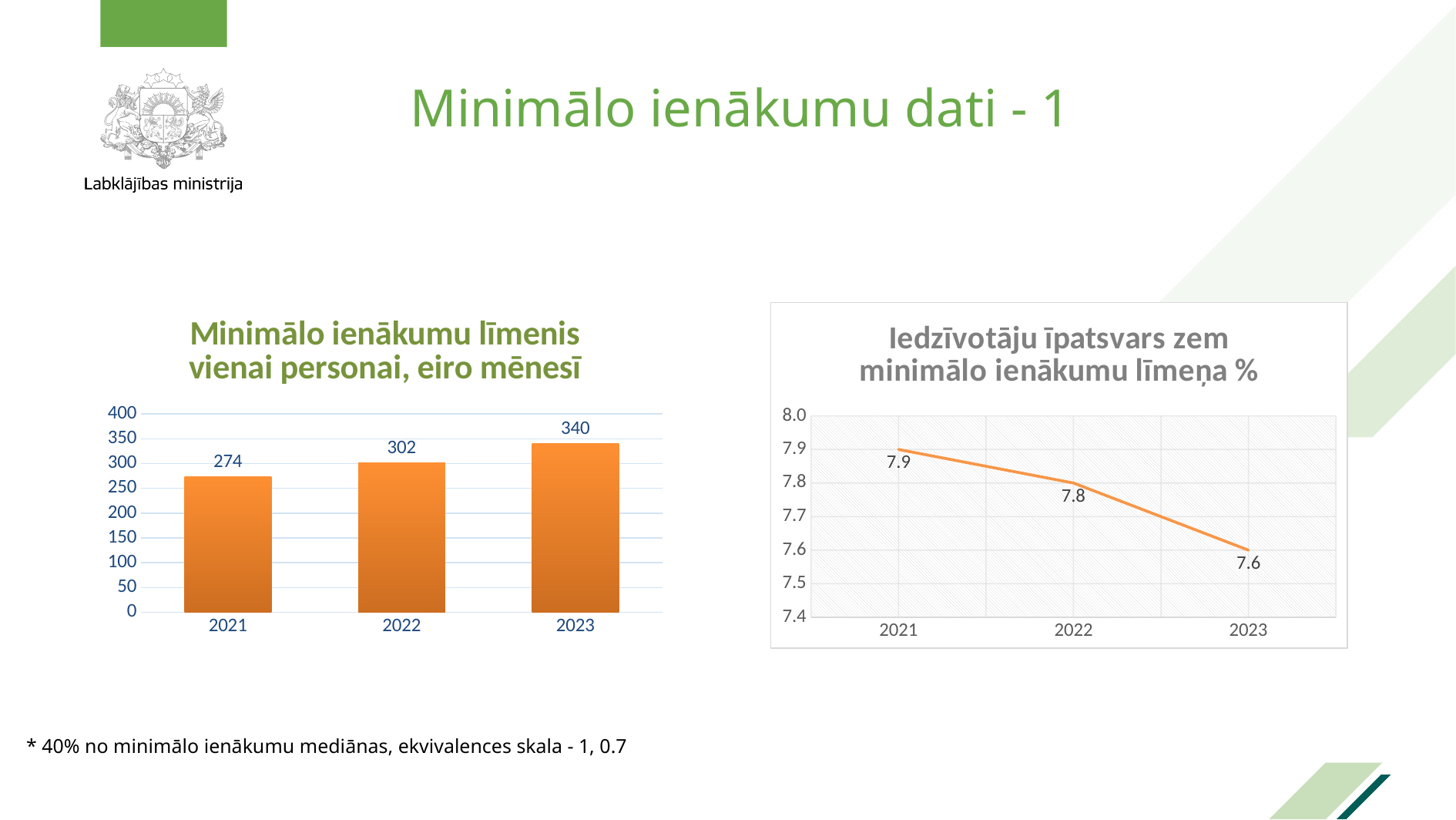
In the right chart 'Iedzīvotāju īpatsvars zem minimālo ienākumu līmeņa %', what is the value for 2021? 7.9 In the right chart 'Iedzīvotāju īpatsvars zem minimālo ienākumu līmeņa %', which year has the lowest value? 2023 In the left chart 'Minimālo ienākumu līmenis vienai personai, eiro mēnesī', what is the difference between the 2023 and 2021 values? 66 In the left chart 'Minimālo ienākumu līmenis vienai personai, eiro mēnesī', what is the value for 2022? 302 What kind of chart is the right chart 'Iedzīvotāju īpatsvars zem minimālo ienākumu līmeņa %'? line chart In the left chart 'Minimālo ienākumu līmenis vienai personai, eiro mēnesī', which year has the highest value? 2023 In the right chart 'Iedzīvotāju īpatsvars zem minimālo ienākumu līmeņa %', what is the difference between the 2021 and 2023 values? 0.3 In the left chart 'Minimālo ienākumu līmenis vienai personai, eiro mēnesī', do the values rise or fall from 2021 to 2023? rise In the left chart 'Minimālo ienākumu līmenis vienai personai, eiro mēnesī', how many years are shown? 3 In the right chart 'Iedzīvotāju īpatsvars zem minimālo ienākumu līmeņa %', do the values rise or fall from 2021 to 2023? fall What kind of chart is the left chart 'Minimālo ienākumu līmenis vienai personai, eiro mēnesī'? bar chart In the left chart 'Minimālo ienākumu līmenis vienai personai, eiro mēnesī', which year has the lowest value? 2021